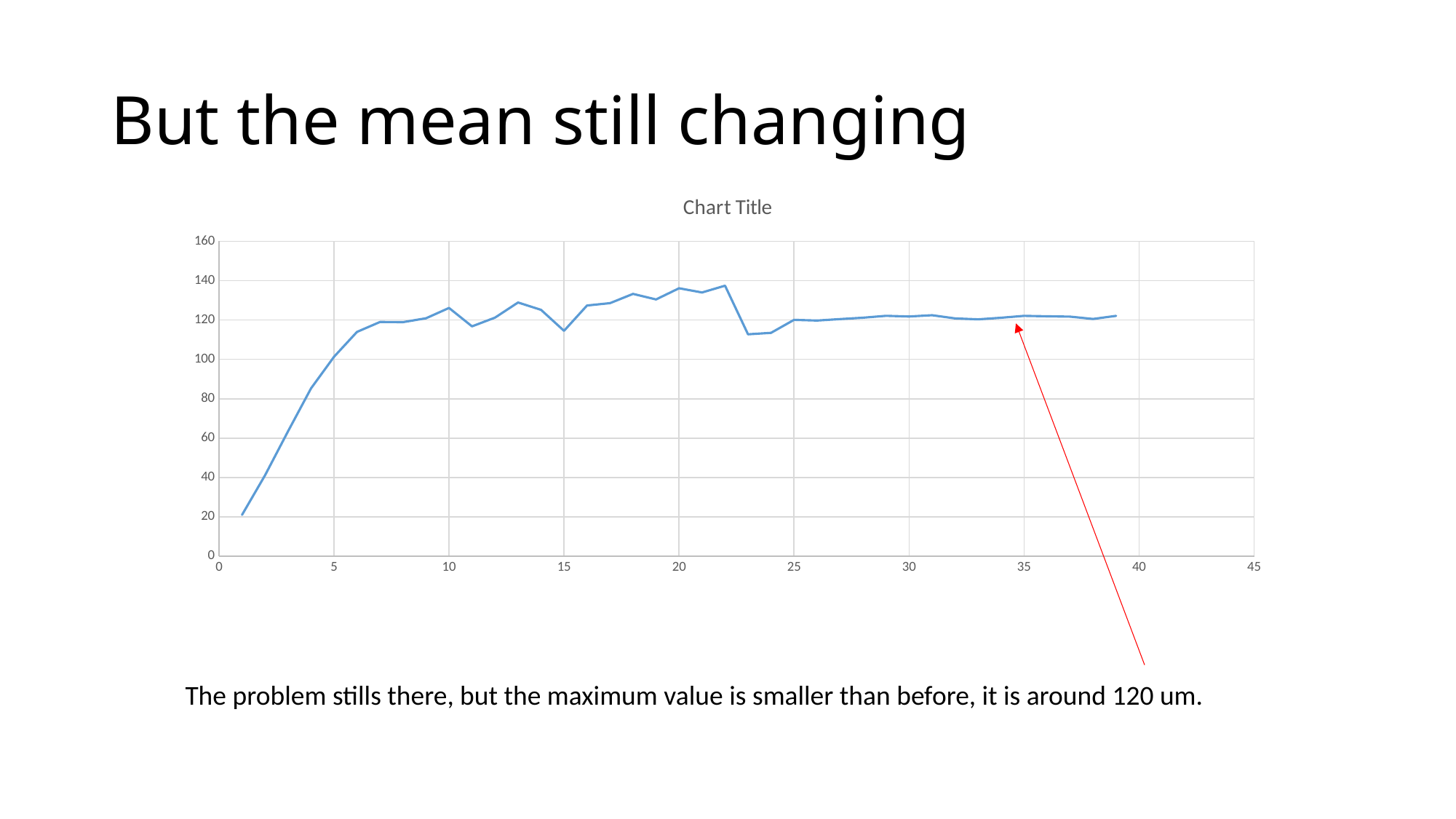
How many lines (series) are plotted on the chart? 1 Is the value at x = 30 greater or less than 100? greater Does the line rise or fall between x = 1 and x = 6? rise What is the title of the chart? Chart Title Is the value at x = 1 greater or less than 40? less Is the value at x = 22 greater or less than 120? greater At roughly which x value does the line reach its lowest point? 1 What kind of chart is shown on the slide? line chart What is the highest value shown on the y axis? 160 Does the line rise or fall between x = 22 and x = 23? fall